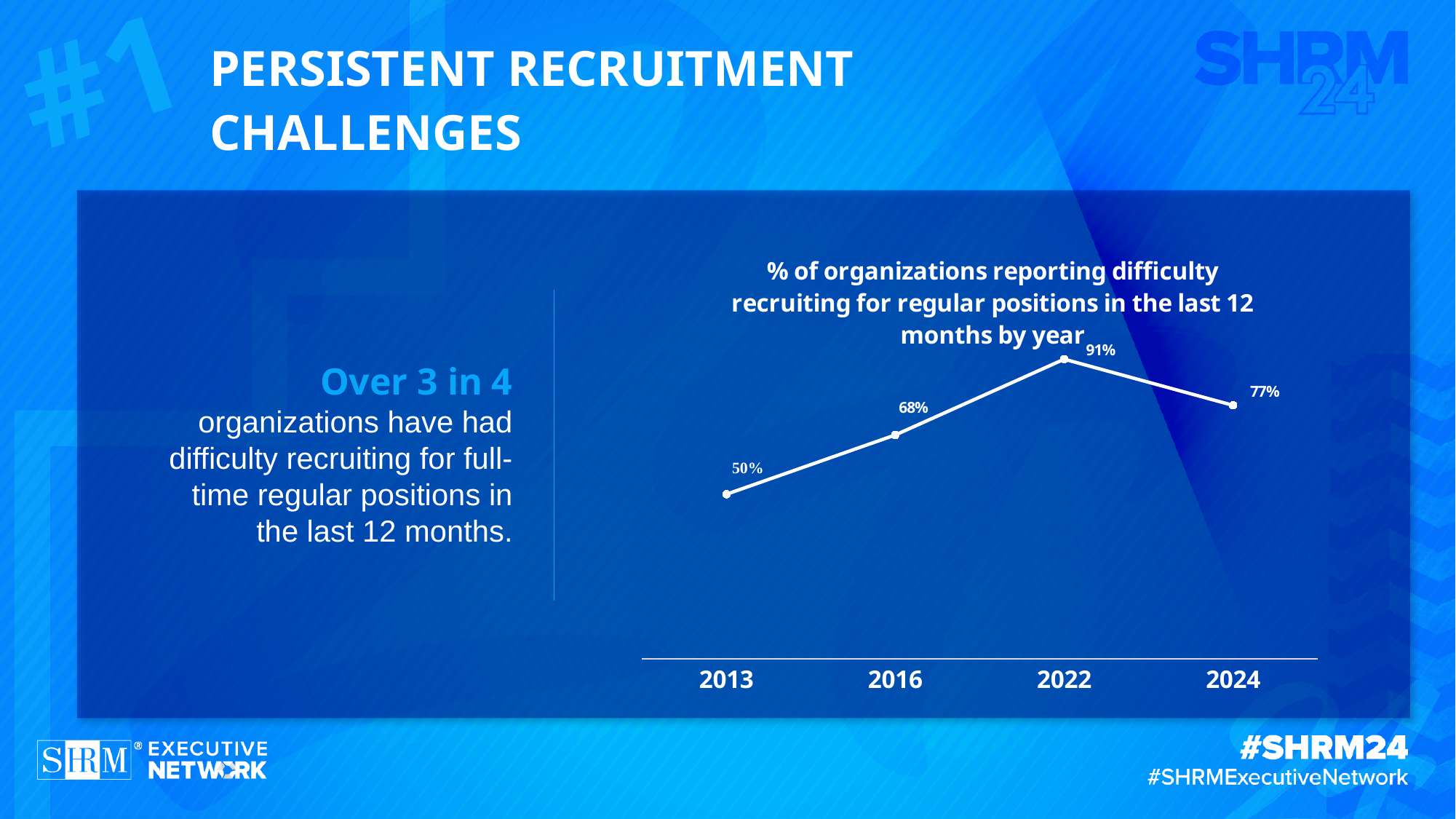
What percentage of organizations reported difficulty recruiting for regular positions in 2022? 91% What percentage of organizations reported difficulty recruiting for regular positions in 2013? 50% What kind of chart is shown on the slide? Line chart By how many percentage points did the share of organizations reporting recruiting difficulty fall from 2022 to 2024? 14 How many years are plotted on the chart? 4 By how many percentage points did the share of organizations reporting recruiting difficulty rise from 2013 to 2016? 18 In which year was the percentage of organizations reporting recruiting difficulty lowest? 2013 In which year was the percentage of organizations reporting recruiting difficulty highest? 2022 What percentage of organizations reported difficulty recruiting for regular positions in 2024? 77% What percentage of organizations reported difficulty recruiting for regular positions in 2016? 68% Did the percentage of organizations reporting recruiting difficulty rise or fall between 2013 and 2022? Rise Which year had a higher percentage of organizations reporting recruiting difficulty, 2016 or 2024? 2024